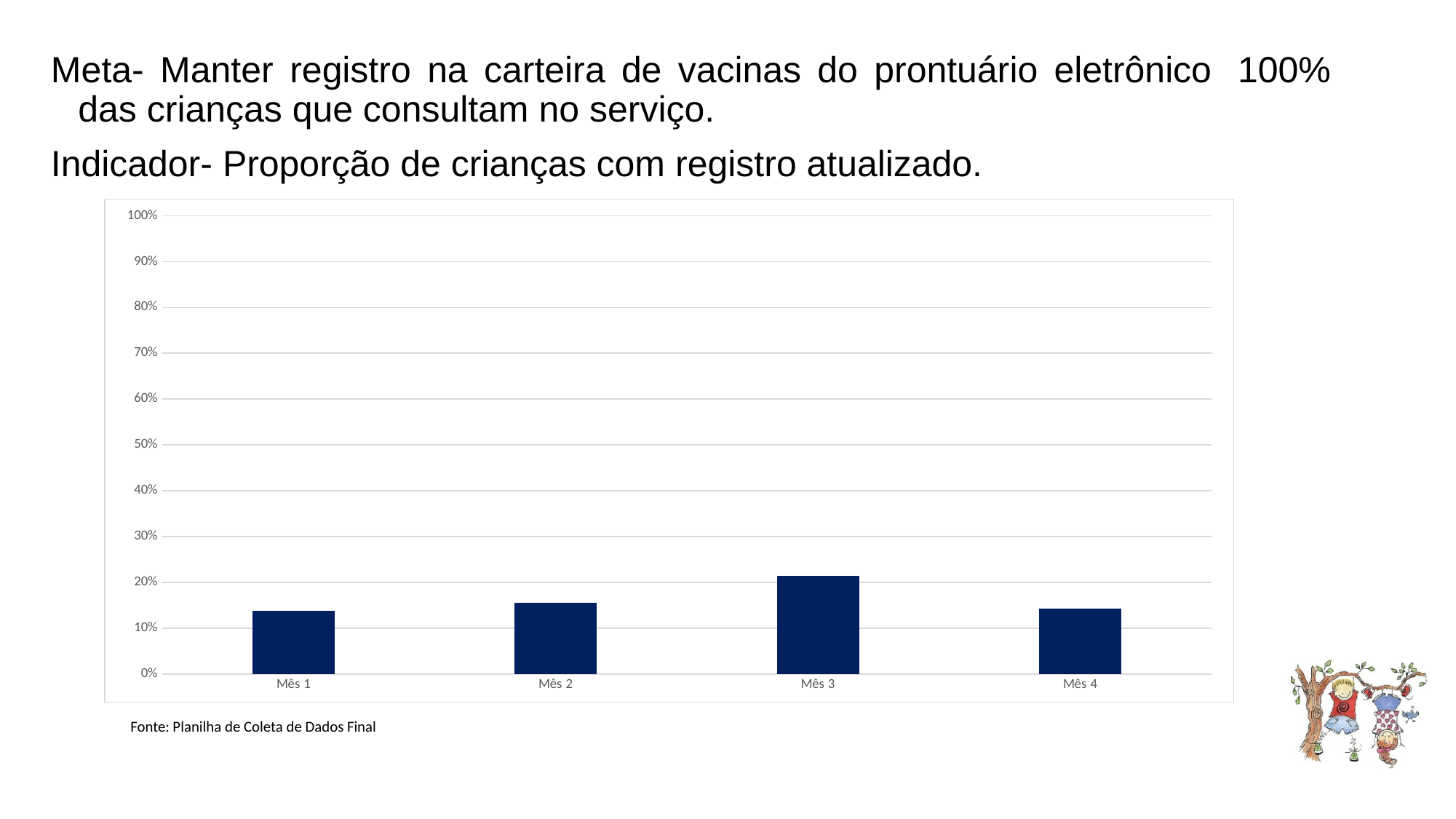
How many categories (months) are shown on the x axis of the chart? 4 Is the value for Mês 4 greater or less than 20%? less Is the value for Mês 1 greater or less than 20%? less What is the highest value shown on the chart's vertical axis? 100% What kind of chart is shown on the slide? bar chart Is the value for Mês 1 greater or less than 10%? greater Do the values rise or fall from Mês 1 to Mês 3? rise What source is cited below the chart? Planilha de Coleta de Dados Final Which month has the highest value in the chart? Mês 3 Which is larger, the value for Mês 3 or the value for Mês 4? Mês 3